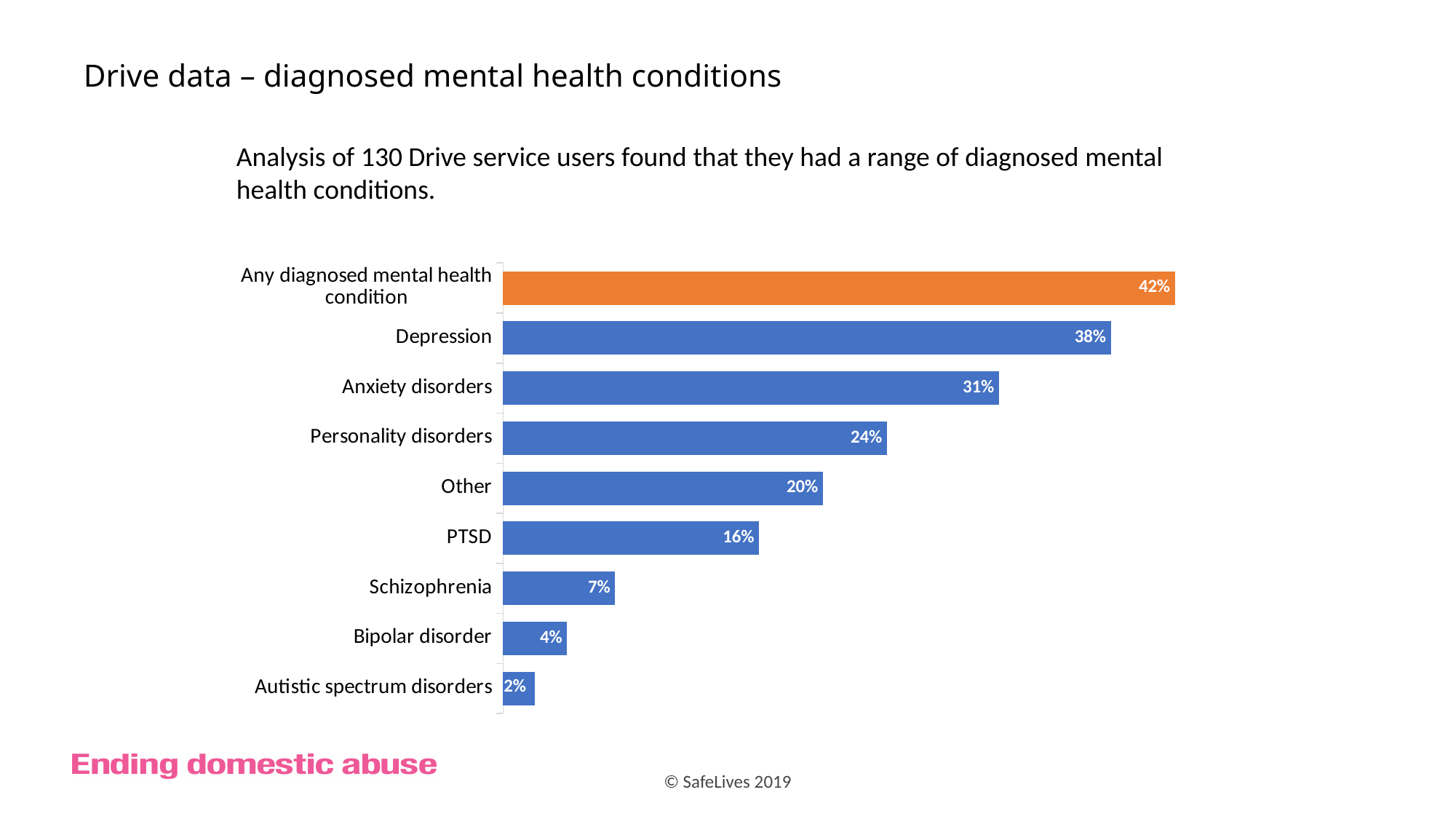
Which category has the highest value on the chart? Any diagnosed mental health condition Which category has the lowest value on the chart? Autistic spectrum disorders What percentage is shown for Autistic spectrum disorders? 2% Which is larger, the value for Other or the value for PTSD? Other What is the value shown for PTSD? 16% Which is larger, the value for Bipolar disorder or the value for Schizophrenia? Schizophrenia Which bar is coloured orange rather than blue? Any diagnosed mental health condition What percentage of Drive service users had depression? 38% What is the difference between the values for Depression and Anxiety disorders? 7% What kind of chart is shown on the slide? Bar chart How many categories are shown on the chart? 9 What is the difference between the values for Personality disorders and Schizophrenia? 17%